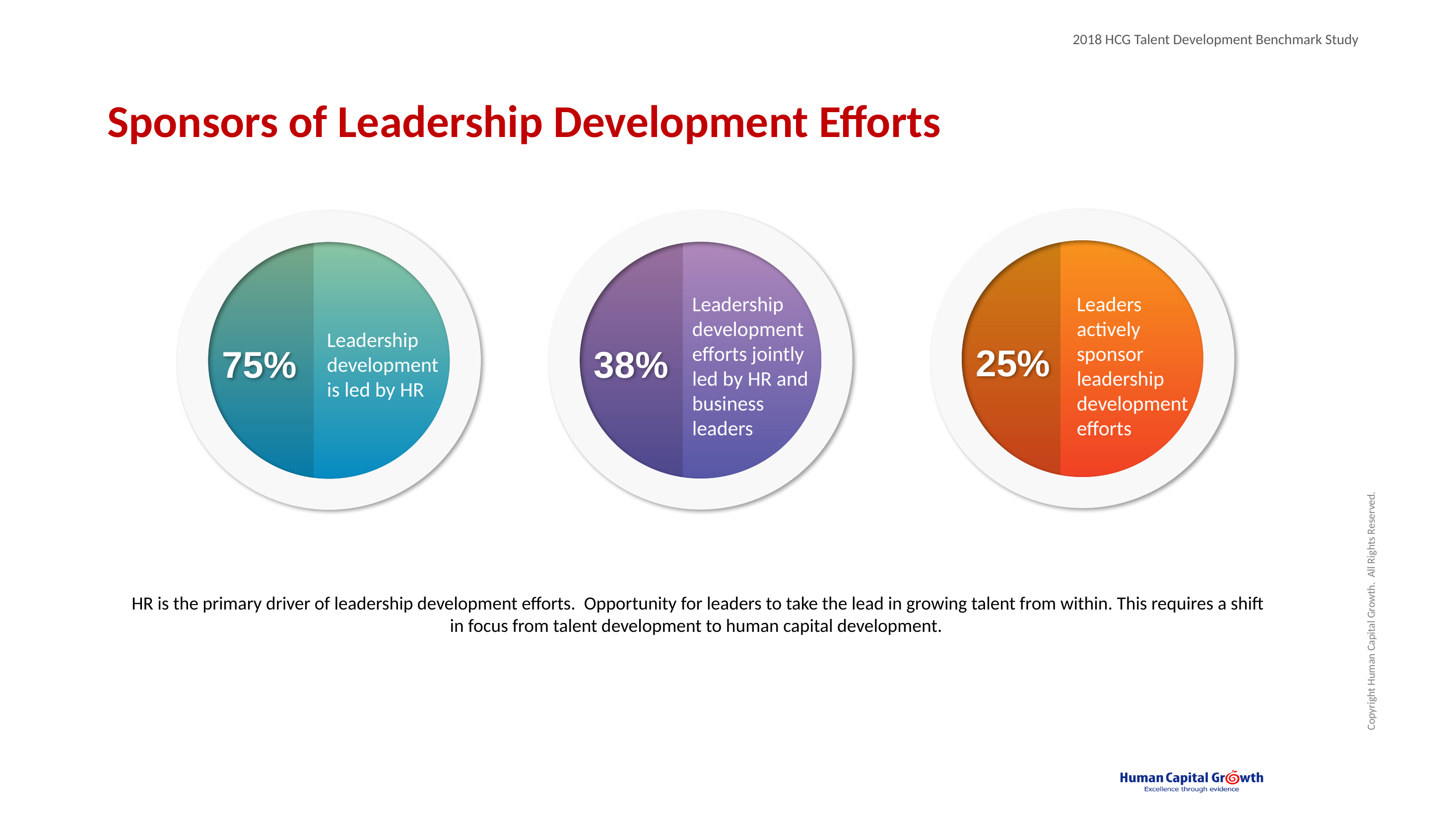
Which is larger: the percentage for efforts jointly led by HR and business leaders, or the percentage for leaders actively sponsoring leadership development efforts? Efforts jointly led by HR and business leaders What percentage is shown for leaders actively sponsoring leadership development efforts? 25% Which sponsor category has the highest percentage on the slide? Leadership development is led by HR What is the title of the slide? Sponsors of Leadership Development Efforts What is the difference in percentage points between leadership development led by HR and leaders actively sponsoring leadership development efforts? 50 What percentage of respondents report that leadership development is led by HR? 75% How many sponsor categories are shown on the slide? 3 What percentage is shown for leadership development efforts jointly led by HR and business leaders? 38% What is the difference in percentage points between leadership development led by HR and efforts jointly led by HR and business leaders? 37 Which sponsor category has the lowest percentage on the slide? Leaders actively sponsor leadership development efforts What colour is the circle showing the 25% value? Orange